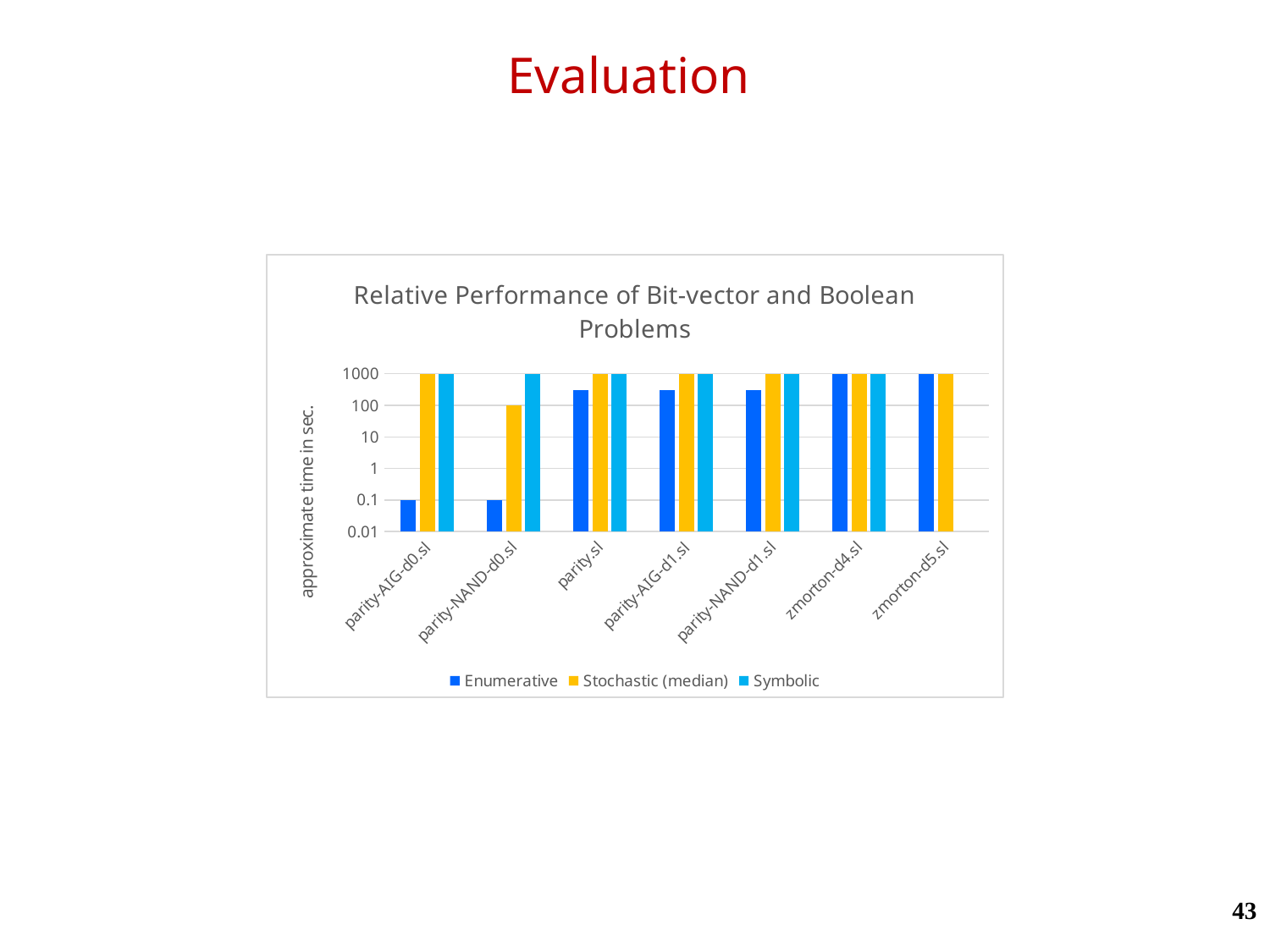
For parity-AIG-d0.sl, which series has the lowest value? Enumerative How many series does the legend list? 3 For parity-NAND-d0.sl, which is larger: the Stochastic (median) value or the Symbolic value? Symbolic What is the Enumerative value for parity-AIG-d0.sl? 0.1 Which category has no Symbolic bar? zmorton-d5.sl What kind of chart is shown on the slide? bar chart Is the Enumerative value for parity.sl greater or less than 100? greater What is the Symbolic value for parity-NAND-d0.sl? 1000 What is the Stochastic (median) value for parity-NAND-d0.sl? 100 What is the label of the y axis? approximate time in sec. How many categories are shown along the x axis? 7 Is the Enumerative value for parity-AIG-d1.sl greater or less than 1000? less